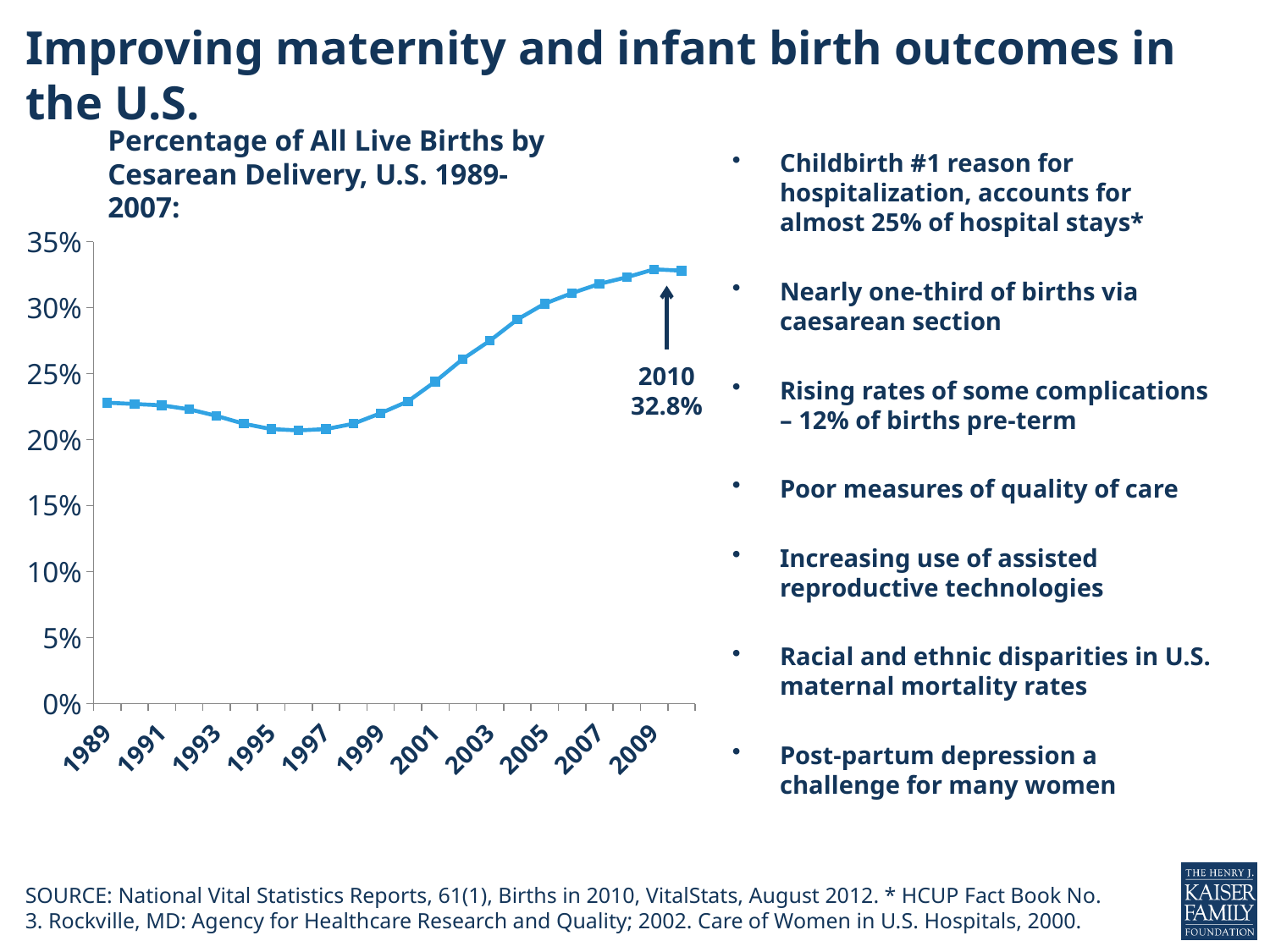
Is the value for 1997 greater or less than 25%? less Is the value for 1989 greater or less than 20%? greater What is the title of the chart? Percentage of All Live Births by Cesarean Delivery, U.S. 1989-2007: Is the value for 2007 greater or less than 30%? greater What is the highest value shown on the y axis? 35% Which year has the larger value, 1995 or 2005? 2005 What percentage of live births were by cesarean delivery in 2010, according to the chart annotation? 32.8% What kind of chart is shown on the slide? line chart Does the cesarean delivery rate rise or fall between 1997 and 2009? rise Which year has the larger value, 1989 or 2009? 2009